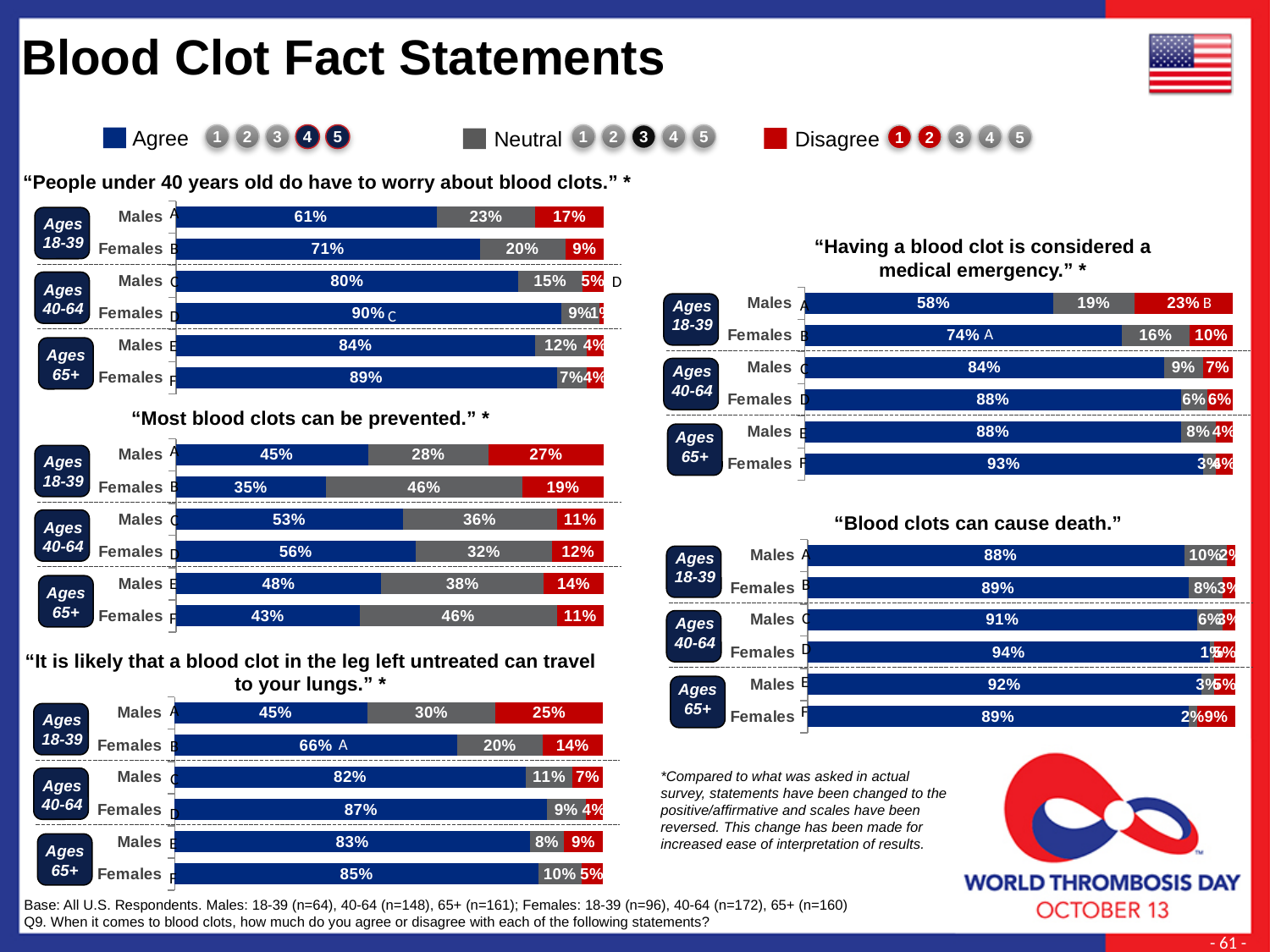
In the chart "Having a blood clot is considered a medical emergency," what percentage of Males aged 18-39 disagree? 23% How many response categories does the legend at the top of the slide list? 3 In the chart "Most blood clots can be prevented," which group has the lowest Agree percentage? Females 18-39 In the chart "People under 40 years old do have to worry about blood clots," what percentage of Females aged 18-39 agree? 71% In the chart "It is likely that a blood clot in the leg left untreated can travel to your lungs," what percentage of Females aged 18-39 agree? 66% In the chart "Having a blood clot is considered a medical emergency," which group has the highest Agree percentage? Females 65+ In the chart "It is likely that a blood clot in the leg left untreated can travel to your lungs," which is larger: the Agree percentage for Males 18-39 or for Females 18-39? Females 18-39 How many groups (bars) are shown in the chart "Blood clots can cause death"? 6 In the chart "People under 40 years old do have to worry about blood clots," which group has the highest Agree percentage? Females 40-64 In the chart "Blood clots can cause death," what percentage of Females aged 40-64 agree? 94% In the chart "Most blood clots can be prevented," what percentage of Males aged 18-39 disagree? 27% In the chart "Most blood clots can be prevented," what is the difference between the Agree percentages of Females 40-64 and Males 40-64? 3%